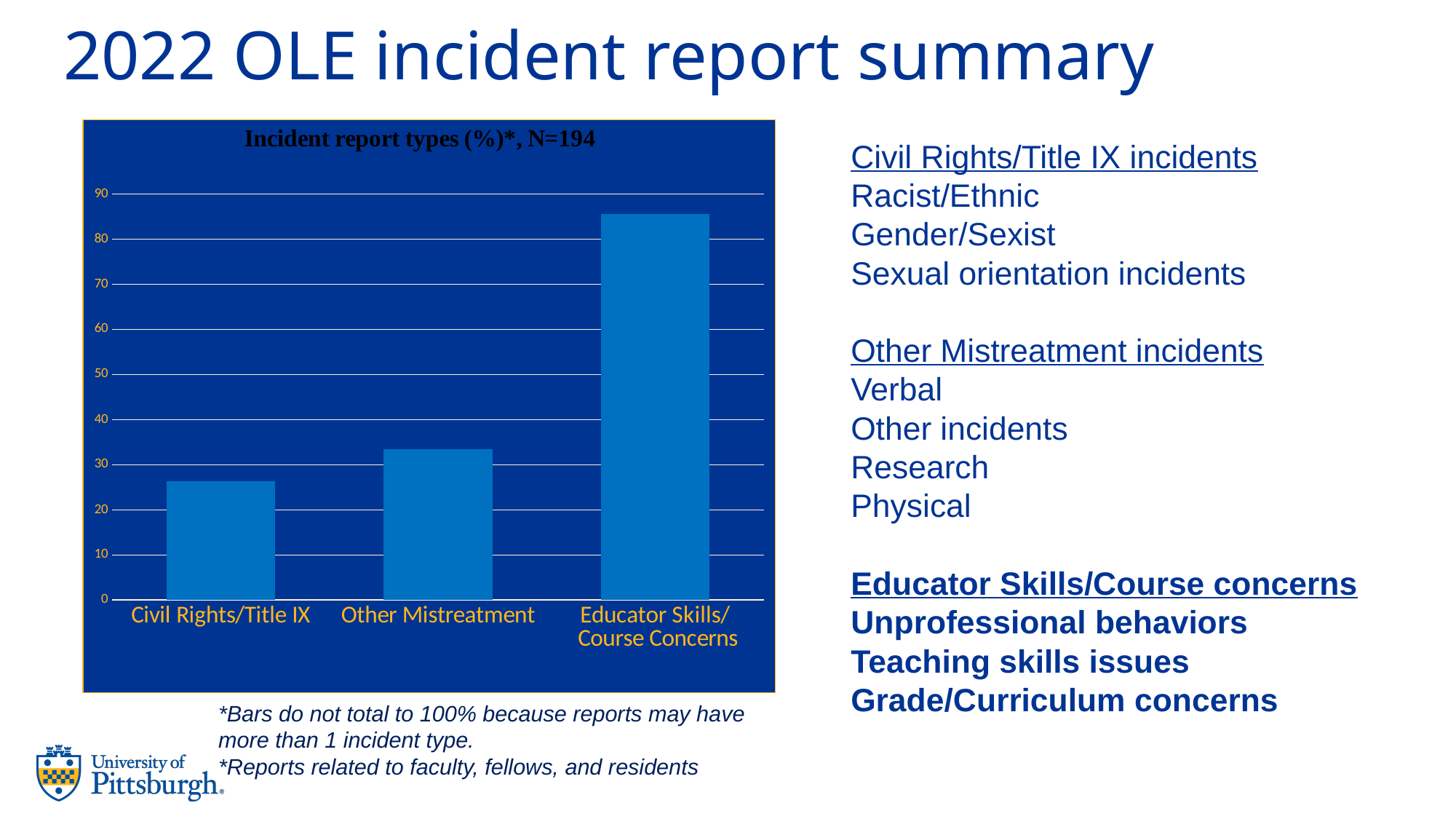
What is the title of the chart? Incident report types (%)*, N=194 Is the value for Educator Skills/Course Concerns greater or less than 80? greater Do the bar values rise or fall from left to right across the categories? rise Is the value for Other Mistreatment greater or less than 30? greater Which category has the highest bar in the chart? Educator Skills/Course Concerns Which category has the lowest bar in the chart? Civil Rights/Title IX Which is larger, the value for Other Mistreatment or the value for Civil Rights/Title IX? Other Mistreatment How many categories are plotted in the chart? 3 Is the value for Other Mistreatment greater or less than 40? less What is the highest value shown on the chart's vertical axis? 90 What kind of chart is shown on the slide? bar chart